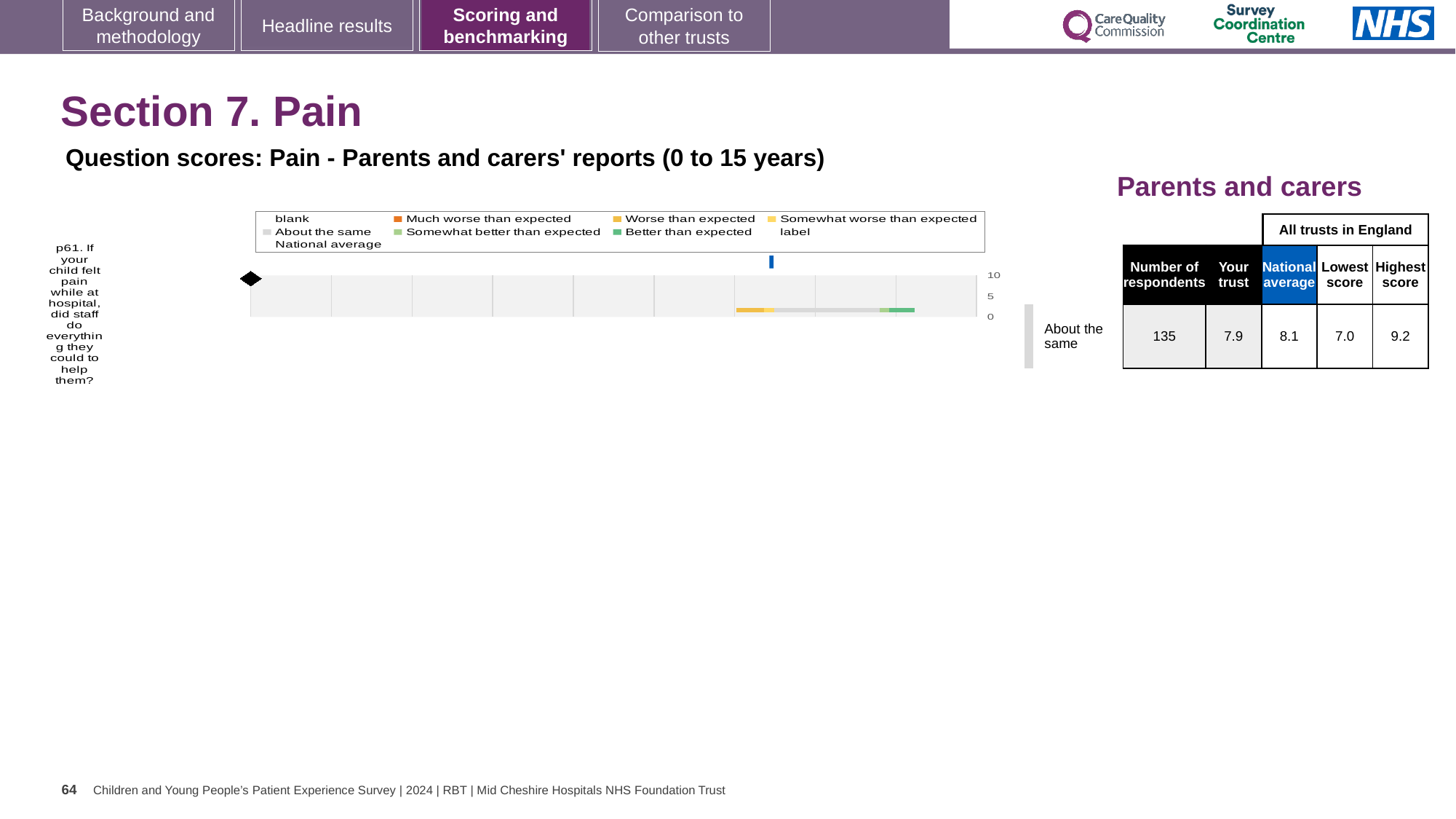
How many survey questions are plotted in the chart? 1 How many respondents answered question p61? 135 What is the difference between the highest score (9.2) and the lowest score (7.0) for question p61? 2.2 How many entries does the chart legend list? 9 Is the national average marker for p61 greater or less than 5 on the score axis? greater What kind of chart is shown on the slide? bar chart What is the 'Your trust' score for question p61? 7.9 What is the highest value shown on the chart's score axis? 10 What is the highest score among all trusts in England for question p61? 9.2 What is the national average score for question p61? 8.1 Which is larger for question p61: the 'Your trust' score or the national average? National average What is the heading above the chart? Question scores: Pain - Parents and carers' reports (0 to 15 years)